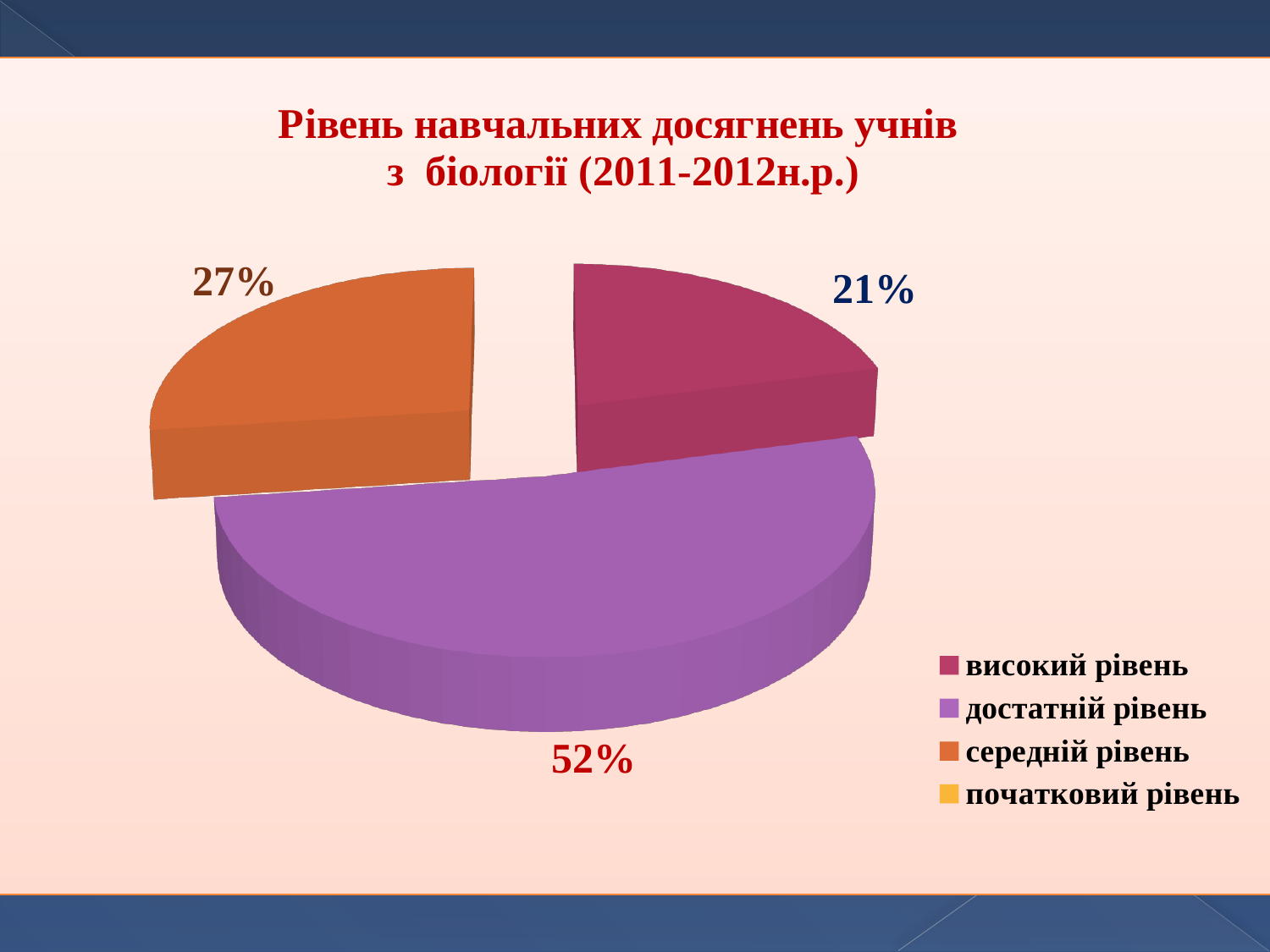
Which of the labelled slices is the smallest? високий рівень What colour is the slice for "середній рівень"? orange Which is larger, the slice for "середній рівень" or the slice for "високий рівень"? середній рівень What kind of chart is shown on the slide? pie chart What is the difference in percentage points between "достатній рівень" and "середній рівень"? 25 Which level has the largest slice of the pie? достатній рівень How many entries does the legend list? 4 What share of the pie does "достатній рівень" have? 52% What share of the pie does "високий рівень" have? 21% What is the title of the chart? Рівень навчальних досягнень учнів з біології (2011-2012н.р.) What is the difference in percentage points between "середній рівень" and "високий рівень"? 6 What share of the pie does "середній рівень" have? 27%